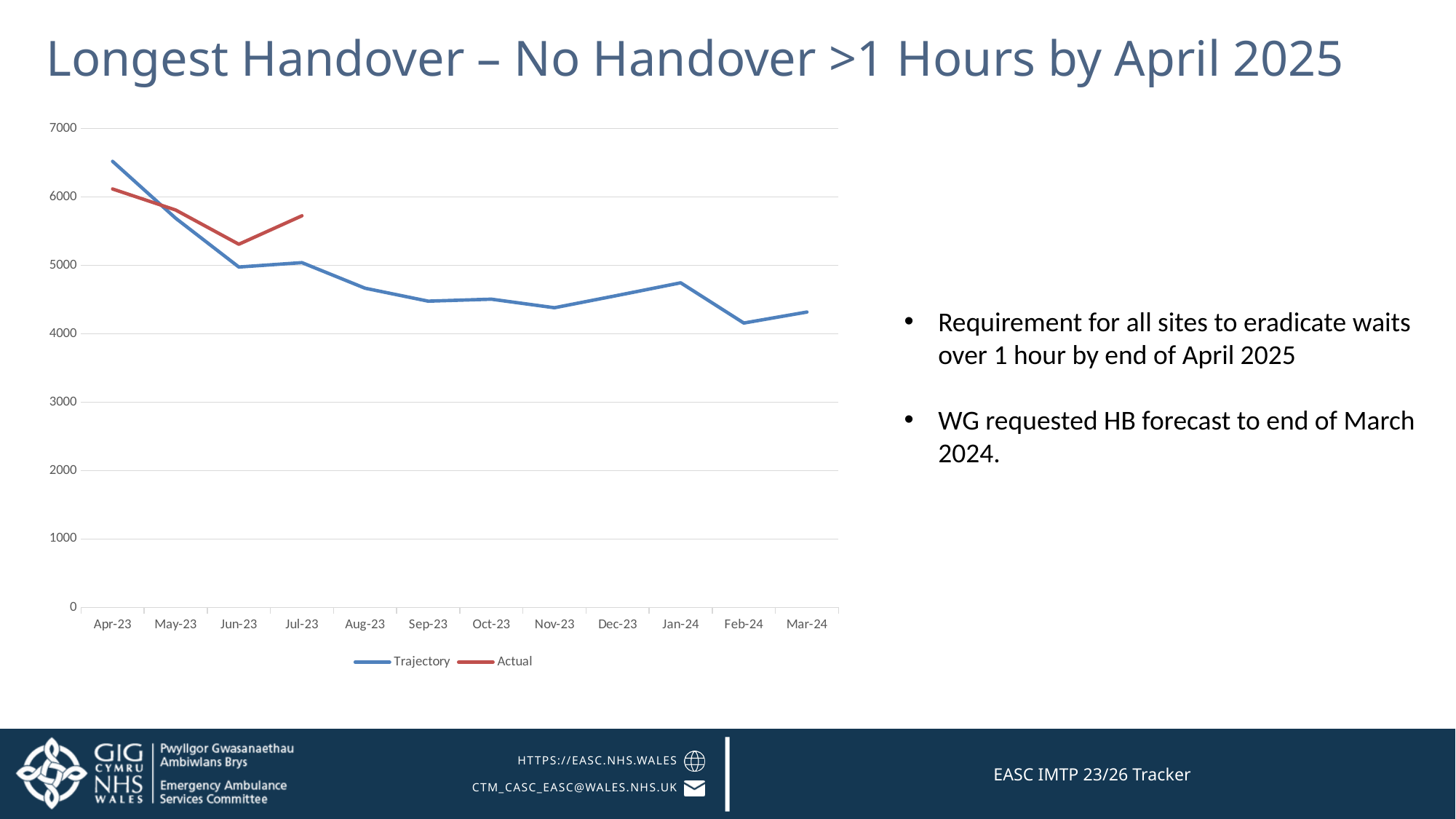
Is the Actual value for Jun-23 greater or less than 5000? greater In which month is the Trajectory series at its lowest value? Feb-24 What colour is the Actual series line in the chart? Red In Apr-23, which series has the higher value, Trajectory or Actual? Trajectory In which month is the Trajectory series at its highest value? Apr-23 What kind of chart is shown on the slide? Line chart Does the Trajectory series generally rise or fall from Apr-23 to Mar-24? Fall In Jul-23, which series has the higher value, Trajectory or Actual? Actual How many months are shown along the x axis of the chart? 12 Is the Trajectory value for Apr-23 greater or less than 6000? greater How many series does the chart legend list? 2 Is the Trajectory value for Feb-24 greater or less than 5000? less